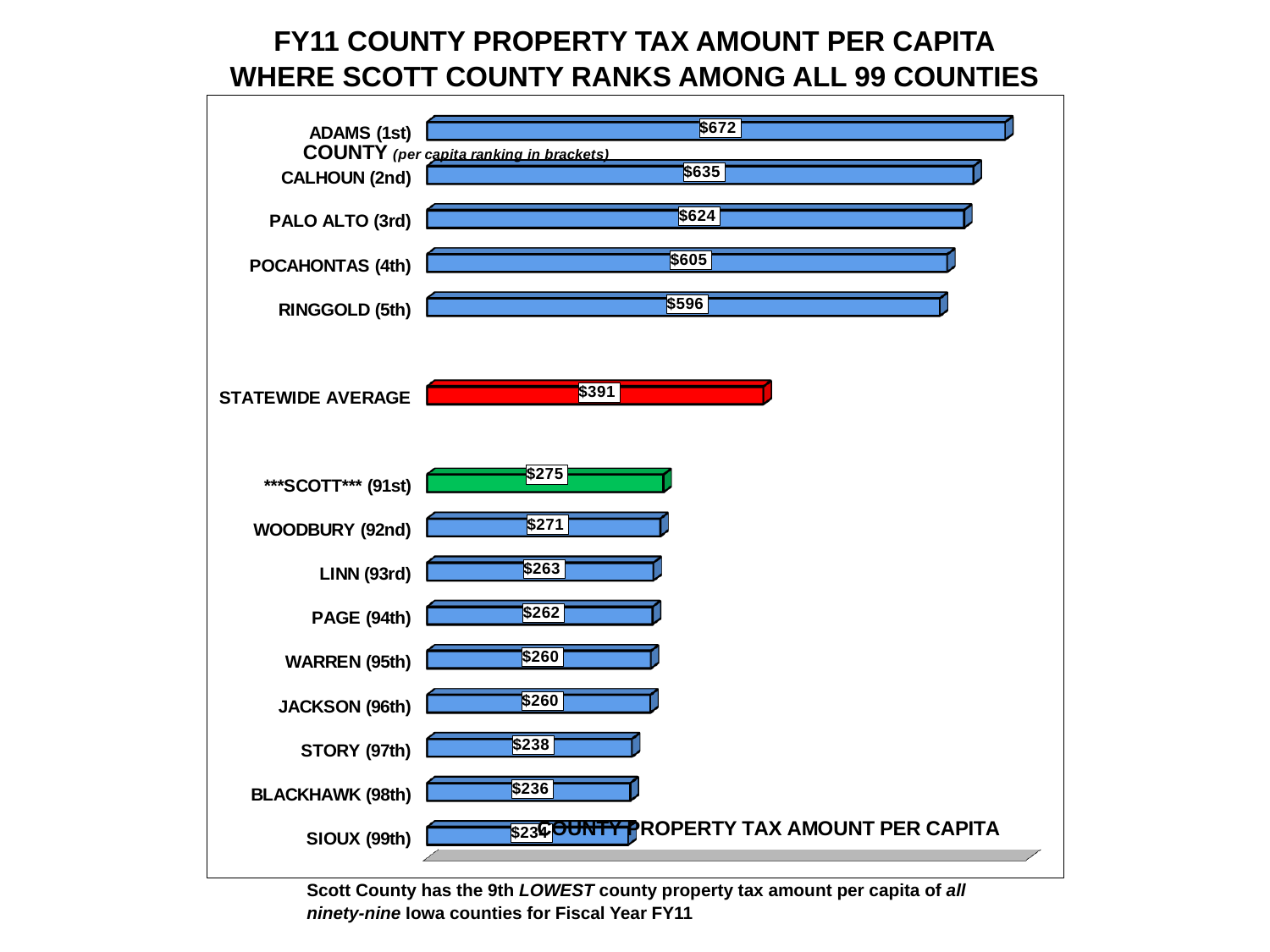
What is the value shown for the STATEWIDE AVERAGE bar? $391 Which county has the highest county property tax amount per capita on the chart? ADAMS (1st) What colour is the ***SCOTT*** (91st) bar? Green What is the difference between the STATEWIDE AVERAGE and the value for ***SCOTT*** (91st)? $116 How many bars are plotted on the chart? 15 What is the difference between the values for ADAMS (1st) and CALHOUN (2nd)? $37 What is the county property tax amount per capita for ***SCOTT*** (91st)? $275 What is the county property tax amount per capita for ADAMS (1st)? $672 What is the value shown for WOODBURY (92nd)? $271 What colour is the STATEWIDE AVERAGE bar? Red What kind of chart is shown on the slide? Bar chart Which is larger, the value for POCAHONTAS (4th) or the value for RINGGOLD (5th)? POCAHONTAS (4th)